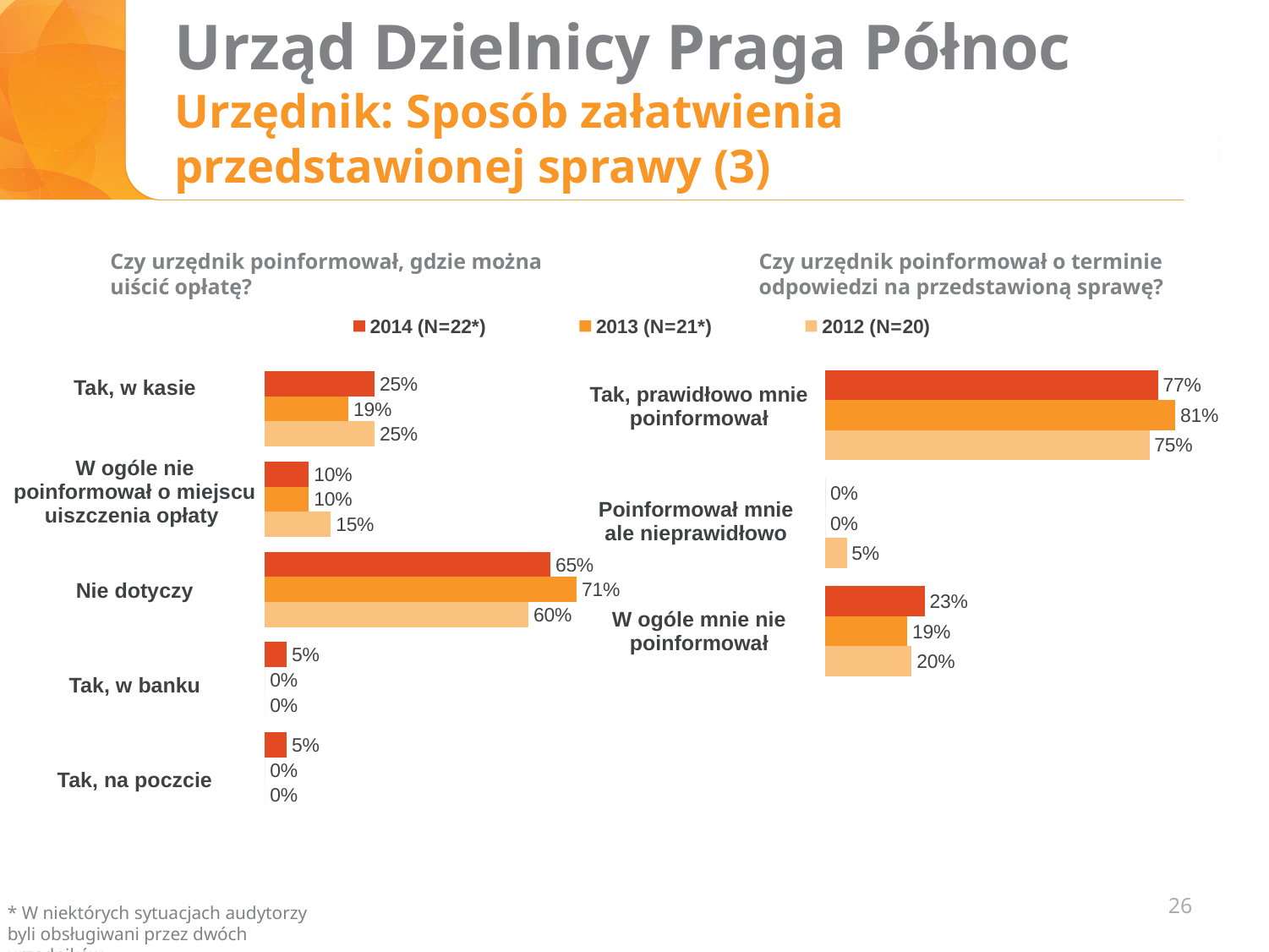
In the left chart ("Czy urzędnik poinformował, gdzie można uiścić opłatę?"), what is the value for "Tak, w kasie" in the 2014 (N=22*) series? 25% In the right chart ("Czy urzędnik poinformował o terminie odpowiedzi na przedstawioną sprawę?"), what is the value for "Tak, prawidłowo mnie poinformował" in the 2012 (N=20) series? 75% In the right chart ("Czy urzędnik poinformował o terminie odpowiedzi na przedstawioną sprawę?"), what is the difference between the 2013 (N=21*) and 2014 (N=22*) values for "Tak, prawidłowo mnie poinformował"? 4 percentage points What kind of chart is the right chart ("Czy urzędnik poinformował o terminie odpowiedzi na przedstawioną sprawę?")? Bar chart In the right chart ("Czy urzędnik poinformował o terminie odpowiedzi na przedstawioną sprawę?"), which category has the highest value in the 2013 (N=21*) series? Tak, prawidłowo mnie poinformował In the left chart ("Czy urzędnik poinformował, gdzie można uiścić opłatę?"), what is the value for "Nie dotyczy" in the 2013 (N=21*) series? 71% In the right chart ("Czy urzędnik poinformował o terminie odpowiedzi na przedstawioną sprawę?"), which is larger for "W ogóle mnie nie poinformował": the 2014 (N=22*) value or the 2012 (N=20) value? 2014 (N=22*) In the left chart ("Czy urzędnik poinformował, gdzie można uiścić opłatę?"), what is the difference between the 2012 (N=20) and 2014 (N=22*) values for "W ogóle nie poinformował o miejscu uiszczenia opłaty"? 5 percentage points How many categories does the left chart ("Czy urzędnik poinformował, gdzie można uiścić opłatę?") show? 5 In the left chart ("Czy urzędnik poinformował, gdzie można uiścić opłatę?"), which category has the highest value in the 2012 (N=20) series? Nie dotyczy How many series does the legend list? 3 In the right chart ("Czy urzędnik poinformował o terminie odpowiedzi na przedstawioną sprawę?"), what is the value for "Poinformował mnie ale nieprawidłowo" in the 2012 (N=20) series? 5%